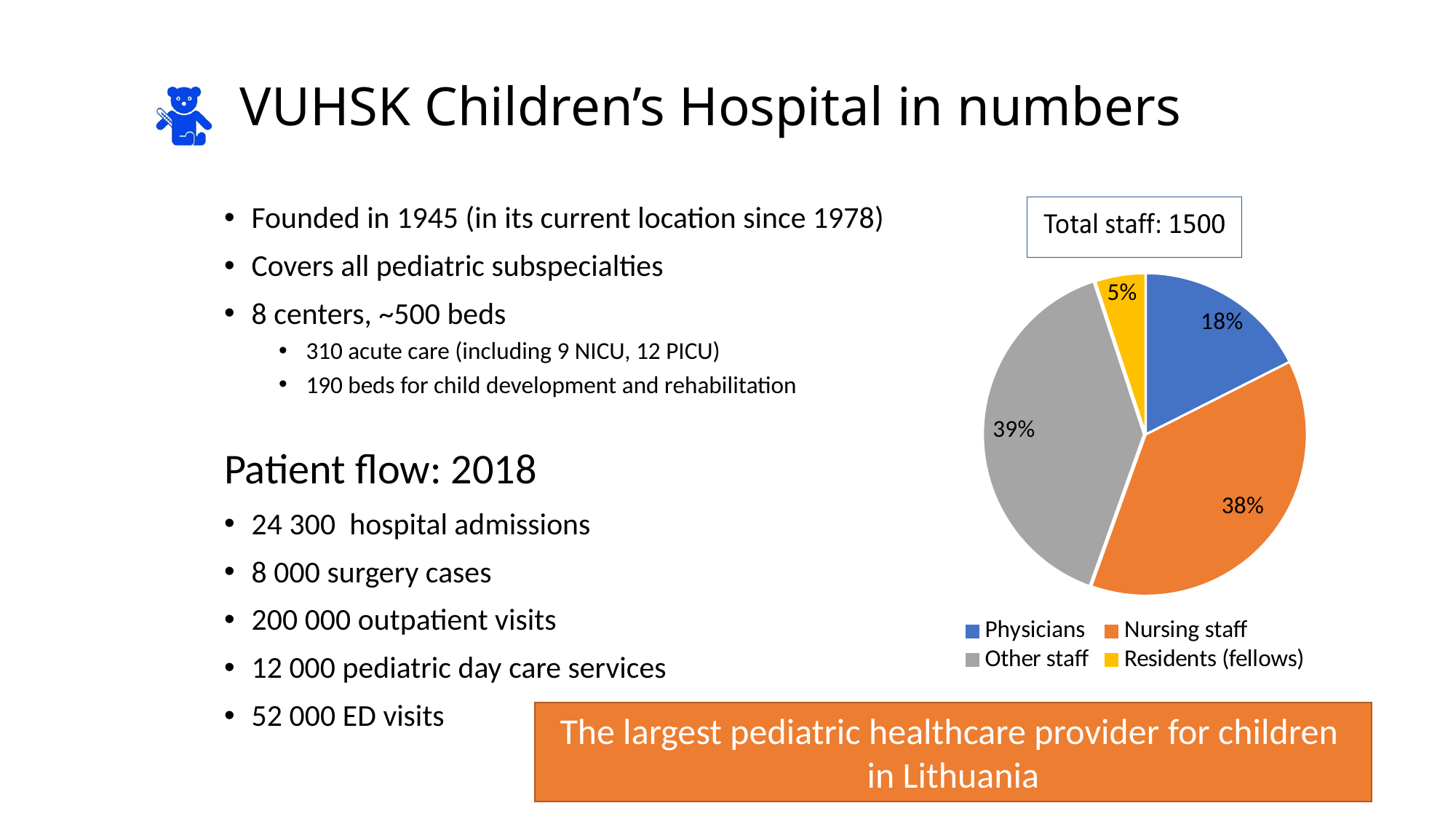
How many staff groups does the legend list? 4 What kind of chart is shown on the slide? pie chart Which colour represents Nursing staff in the pie chart? orange Which staff group has the smallest share of the pie? Residents (fellows) What share of the total staff are Physicians? 18% What share of the total staff is Other staff? 39% Which staff group has the largest share of the pie? Other staff Which group has a larger share, Physicians or Nursing staff? Nursing staff What share of the total staff is Nursing staff? 38% What is the difference in percentage points between the Nursing staff share and the Physicians share? 20 What total staff number is stated above the pie chart? 1500 What share of the total staff are Residents (fellows)? 5%